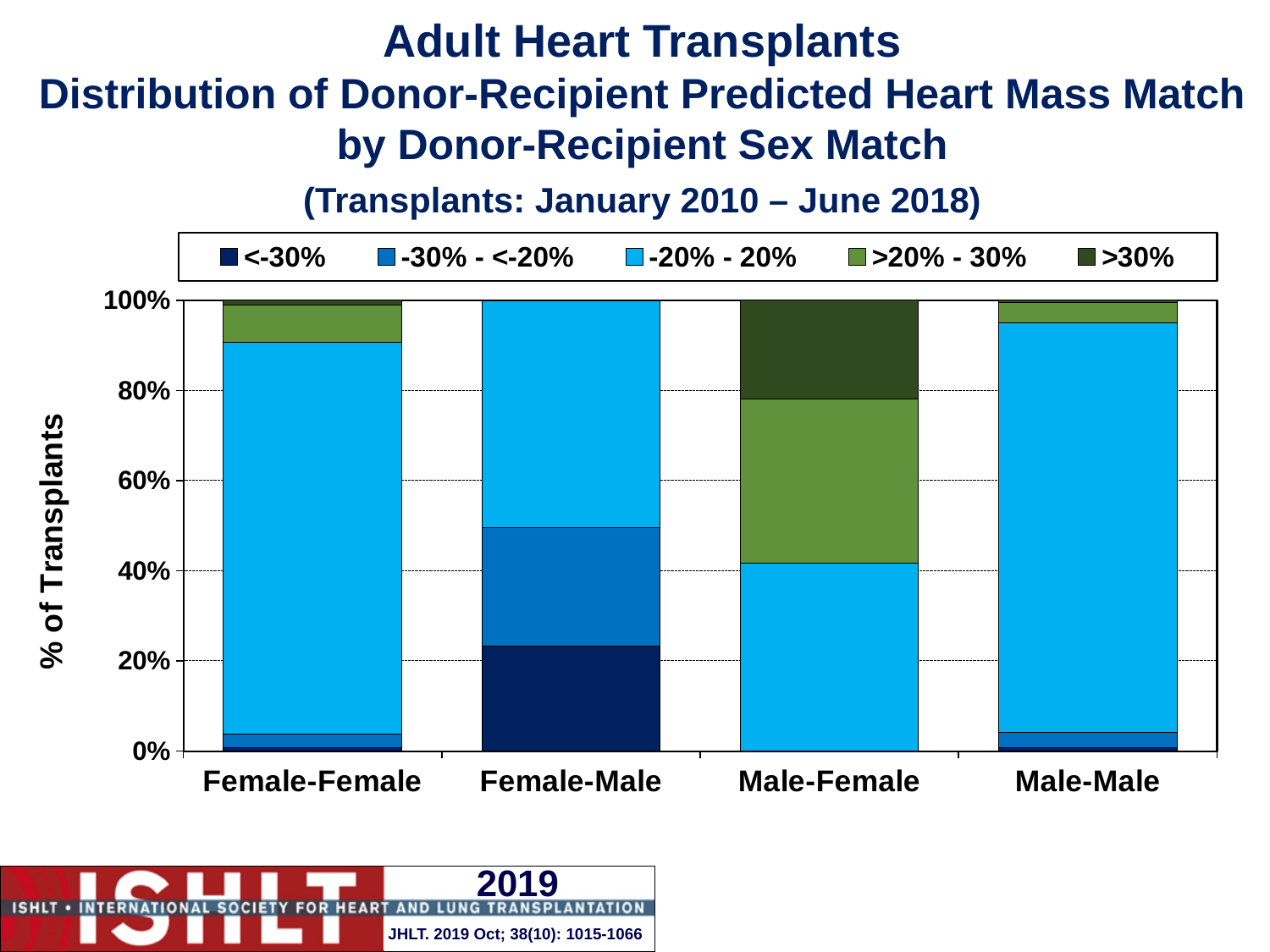
How many donor-recipient sex match categories are shown on the x axis? 4 What kind of chart is shown on the slide? Stacked bar chart What transplant date range is given in the chart title? January 2010 – June 2018 How many series does the legend list? 5 Which category has the largest <-30% segment? Female-Male What is the label of the y axis? % of Transplants Is the -20% - 20% share larger for Female-Female or for Male-Female? Female-Female Which category has the largest >30% segment? Male-Female Is the -20% - 20% share for Male-Female greater or less than 60%? less Is the >20% - 30% share for Male-Female greater or less than 20%? greater Is the -20% - 20% share for Male-Male greater or less than 80%? greater